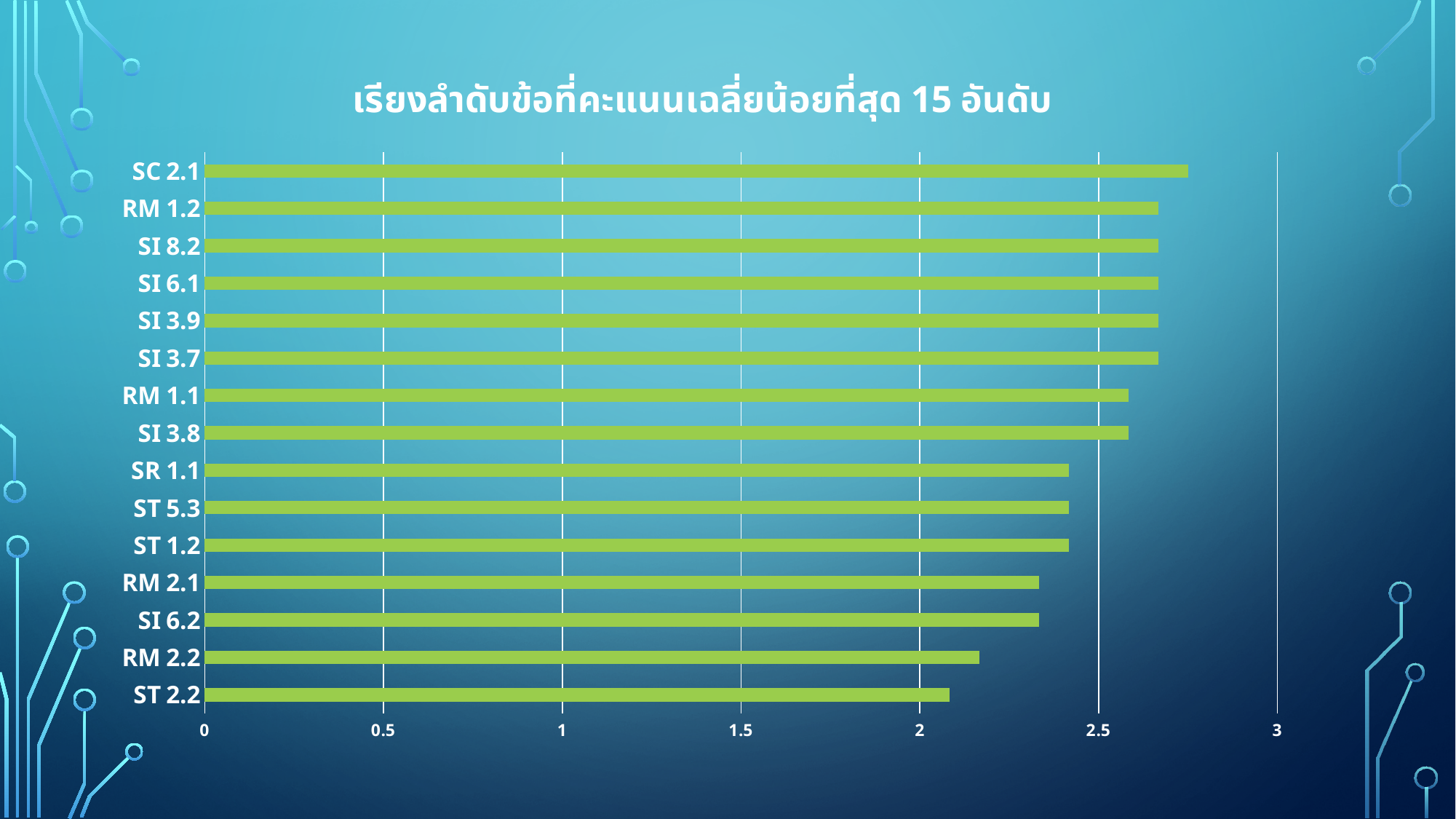
Which is larger, the value for SR 1.1 or the value for RM 2.1? SR 1.1 Which is larger, the value for SC 2.1 or the value for ST 2.2? SC 2.1 How many categories are plotted in the chart? 15 Which category has the lowest value in the chart? ST 2.2 Is the value for RM 2.2 greater or less than 2.5? less What kind of chart is shown on the slide? bar chart Is the value for SR 1.1 greater or less than 2.5? less Is the value for ST 2.2 greater or less than 2? greater What is the title of the chart? เรียงลำดับข้อที่คะแนนเฉลี่ยน้อยที่สุด 15 อันดับ Which category has the highest value in the chart? SC 2.1 Do the bar values increase or decrease going from the top category to the bottom category? decrease